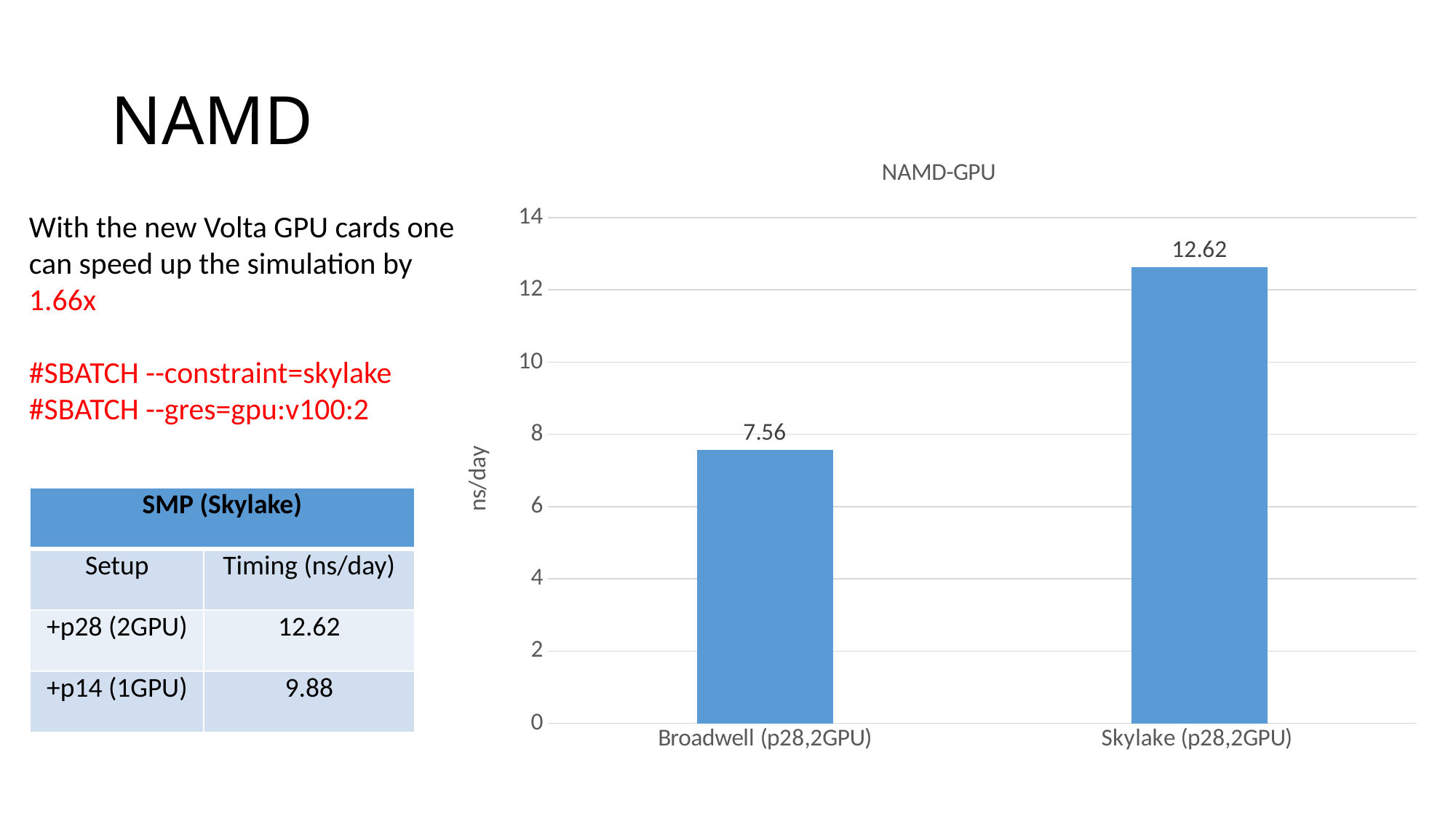
What is the title of the chart on the slide? NAMD-GPU What is the difference between the Skylake (p28,2GPU) and Broadwell (p28,2GPU) values in the NAMD-GPU chart? 5.06 Is the value for Skylake (p28,2GPU) greater or less than 12? greater What kind of chart is the NAMD-GPU chart? bar chart Which category has the highest value in the NAMD-GPU chart? Skylake (p28,2GPU) What is the label of the vertical axis in the NAMD-GPU chart? ns/day Which category has the lowest value in the NAMD-GPU chart? Broadwell (p28,2GPU) Is the value for Broadwell (p28,2GPU) greater or less than 8? less What is the value for Skylake (p28,2GPU) in the NAMD-GPU chart? 12.62 How many categories are shown in the NAMD-GPU chart? 2 What is the value for Broadwell (p28,2GPU) in the NAMD-GPU chart? 7.56 Which is larger in the NAMD-GPU chart: Broadwell (p28,2GPU) or Skylake (p28,2GPU)? Skylake (p28,2GPU)